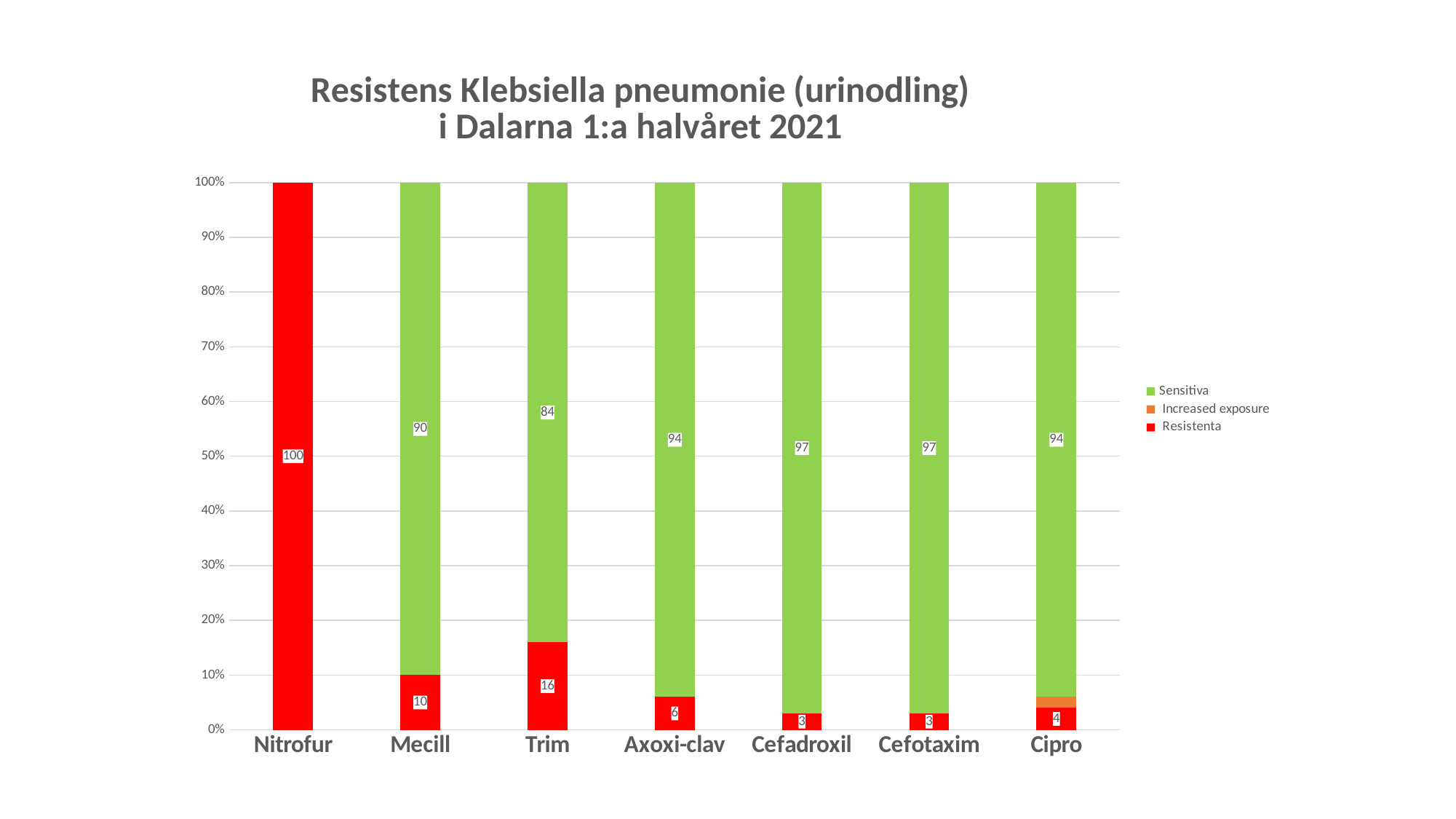
Which has a larger Resistenta value, Axoxi-clav or Cefadroxil? Axoxi-clav What kind of chart is shown on the slide? Stacked bar chart What is the Resistenta value for Cipro? 4 What is the Sensitiva value for Cefotaxim? 97 How many series does the legend list? 3 How many categories are shown on the x axis? 7 What is the Resistenta value for Nitrofur? 100 What is the Sensitiva value for Trim? 84 What is the Resistenta value for Mecill? 10 Which category has the highest Resistenta value? Nitrofur What is the difference between the Resistenta values for Trim and Mecill? 6 Is the Increased exposure value for Cipro greater or less than 10%? less